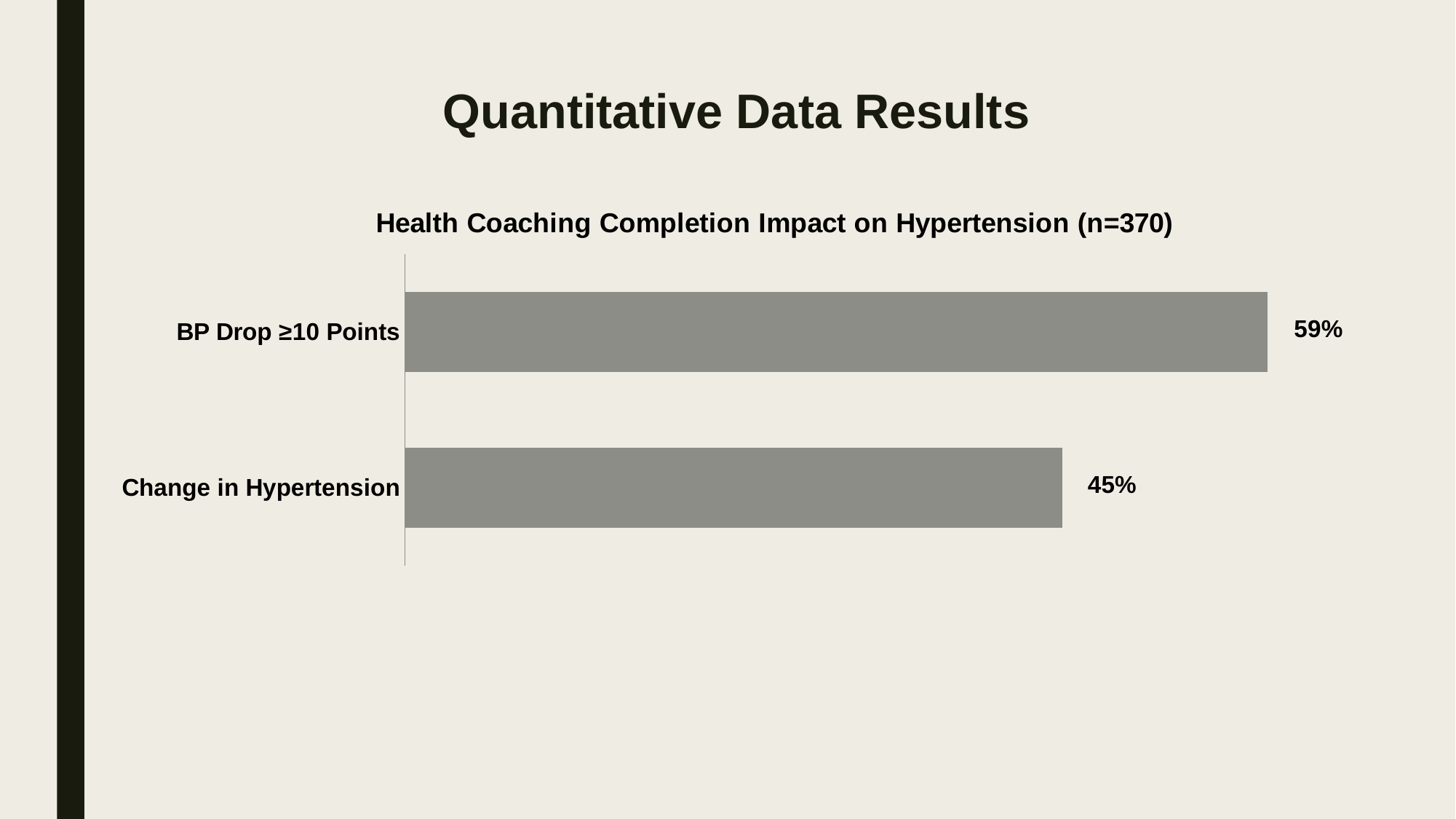
What kind of chart is shown on the slide? Bar chart Which category has the lowest value? Change in Hypertension Which category has the highest value? BP Drop ≥10 Points How many categories are shown in the chart? 2 Which is larger, the value for BP Drop ≥10 Points or the value for Change in Hypertension? BP Drop ≥10 Points What is the sample size (n) stated in the chart title? 370 What is the value for BP Drop ≥10 Points? 59% What is the title of the chart? Health Coaching Completion Impact on Hypertension (n=370) What is the value for Change in Hypertension? 45% What is the difference between the values for BP Drop ≥10 Points and Change in Hypertension? 14%